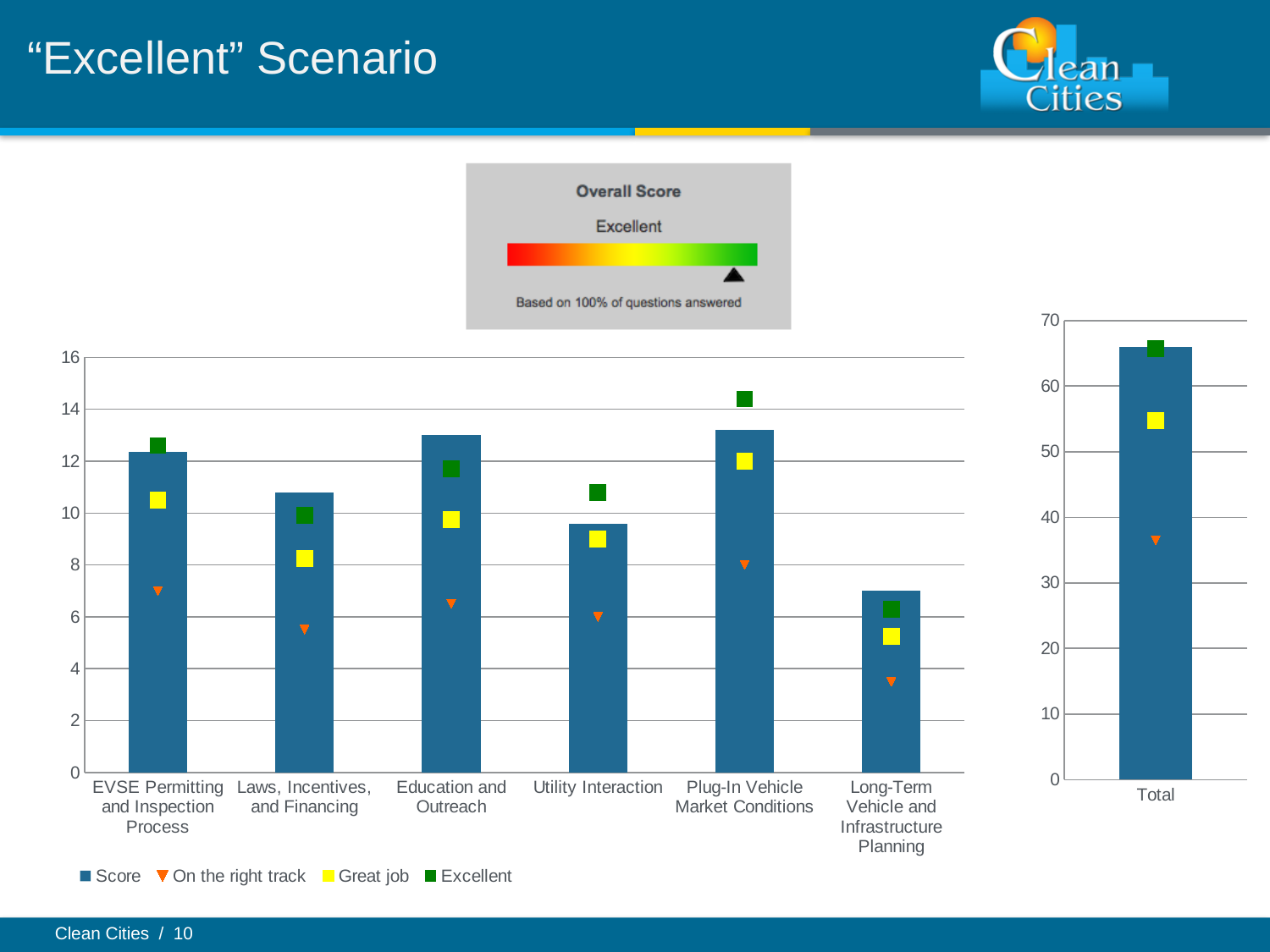
On the right chart, is the Score for Total greater or less than 60? greater On the left chart, which category has the lowest Score bar? Long-Term Vehicle and Infrastructure Planning What kind of chart is the right chart showing Total? Bar chart How many categories are shown on the x axis of the left chart? 6 On the left chart, is the Score for Long-Term Vehicle and Infrastructure Planning greater or less than 8? less On the left chart, is the Score for EVSE Permitting and Inspection Process greater or less than 10? greater How many series does the legend below the left chart list? 4 On the left chart, which has the larger Score bar: Laws, Incentives, and Financing or Utility Interaction? Laws, Incentives, and Financing On the left chart, which has the larger Score bar: EVSE Permitting and Inspection Process or Long-Term Vehicle and Infrastructure Planning? EVSE Permitting and Inspection Process